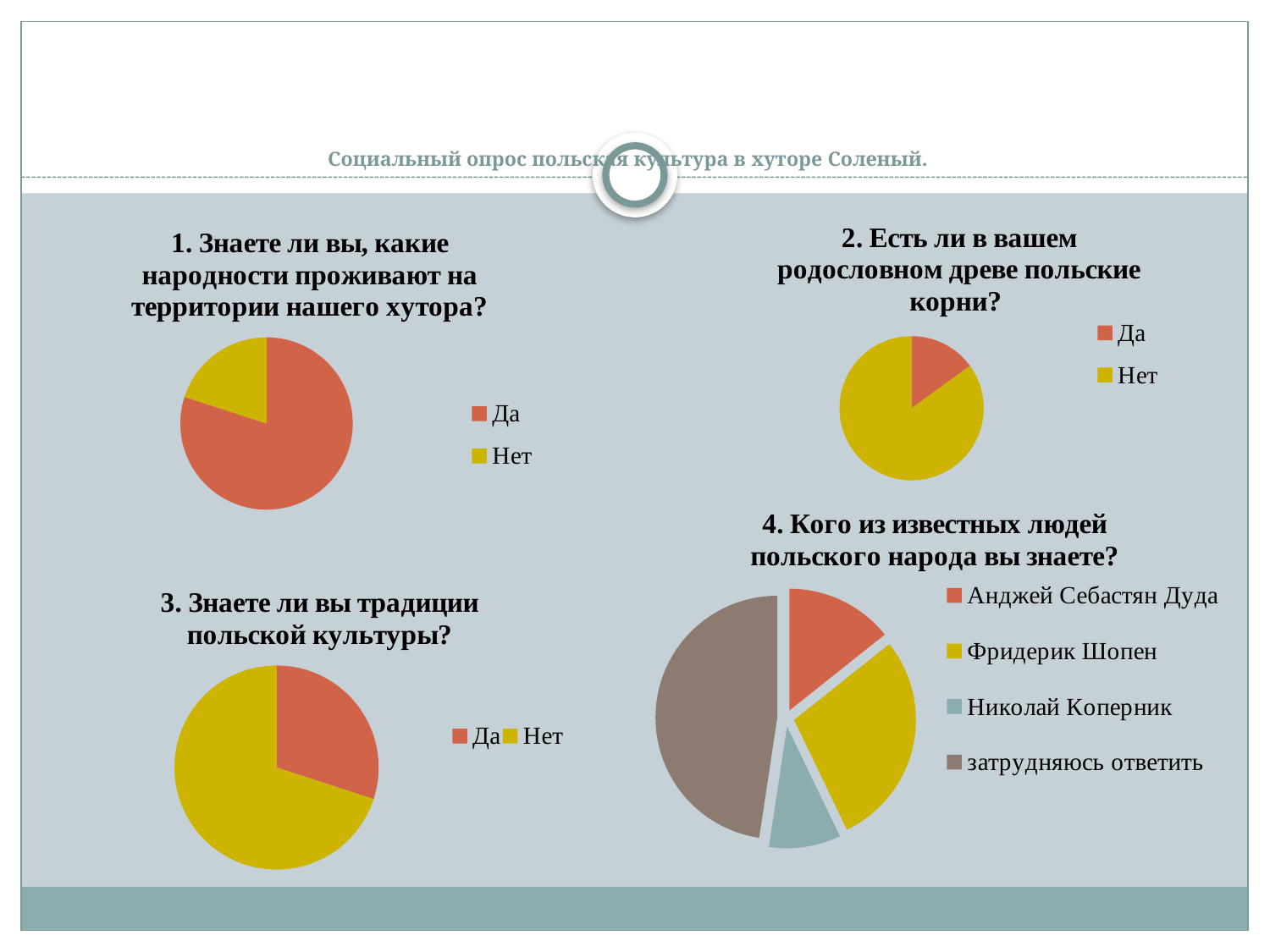
In the chart for question 4 ("Кого из известных людей польского народа вы знаете?"), which slice is larger, Фридерик Шопен or Анджей Себастян Дуда? Фридерик Шопен How many slices does the pie chart for question 3 ("Знаете ли вы традиции польской культуры?") have? 2 How many pie charts are shown on the slide? 4 In the chart for question 1 ("Знаете ли вы, какие народности проживают на территории нашего хутора?"), which answer has the largest slice? Да In the chart for question 4 ("Кого из известных людей польского народа вы знаете?"), what colour is the slice for Николай Коперник? Teal (blue-grey) In the chart for question 3 ("Знаете ли вы традиции польской культуры?"), which is larger, Да or Нет? Нет In the chart for question 4 ("Кого из известных людей польского народа вы знаете?"), which category has the largest slice? затрудняюсь ответить In the chart for question 2 ("Есть ли в вашем родословном древе польские корни?"), which answer has the smallest slice? Да How many entries does the legend of the chart for question 4 ("Кого из известных людей польского народа вы знаете?") list? 4 In the chart for question 4 ("Кого из известных людей польского народа вы знаете?"), which category has the smallest slice? Николай Коперник In the chart for question 2 ("Есть ли в вашем родословном древе польские корни?"), which answer has the largest slice? Нет What kind of chart is used for question 1, "Знаете ли вы, какие народности проживают на территории нашего хутора?"? Pie chart